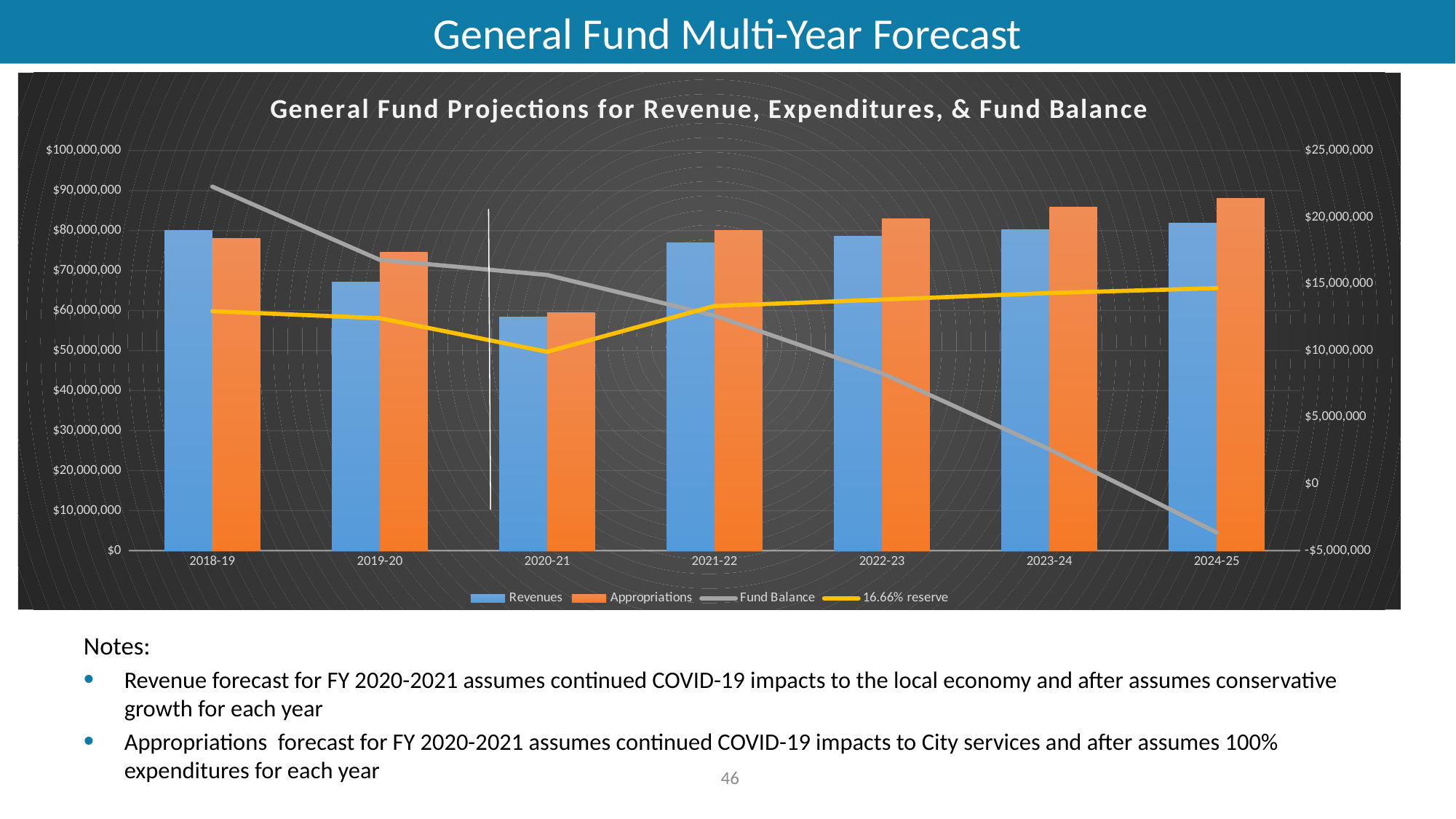
In 2024-25, which is larger: Revenues or Appropriations? Appropriations In which fiscal year is the Fund Balance lowest? 2024-25 What kind of chart is used to show Revenues and Appropriations? Bar chart Is the Appropriations value for 2024-25 greater or less than $80,000,000? greater In which fiscal year are Appropriations highest? 2024-25 What colour is the Fund Balance line in the legend? Gray Is the Revenues value for 2020-21 greater or less than $60,000,000? less In which fiscal year are Revenues lowest? 2020-21 How many fiscal years are shown on the x axis? 7 In 2018-19, which is larger: Revenues or Appropriations? Revenues Does the Fund Balance line rise or fall from 2018-19 to 2024-25? Falls How many series does the legend list? 4